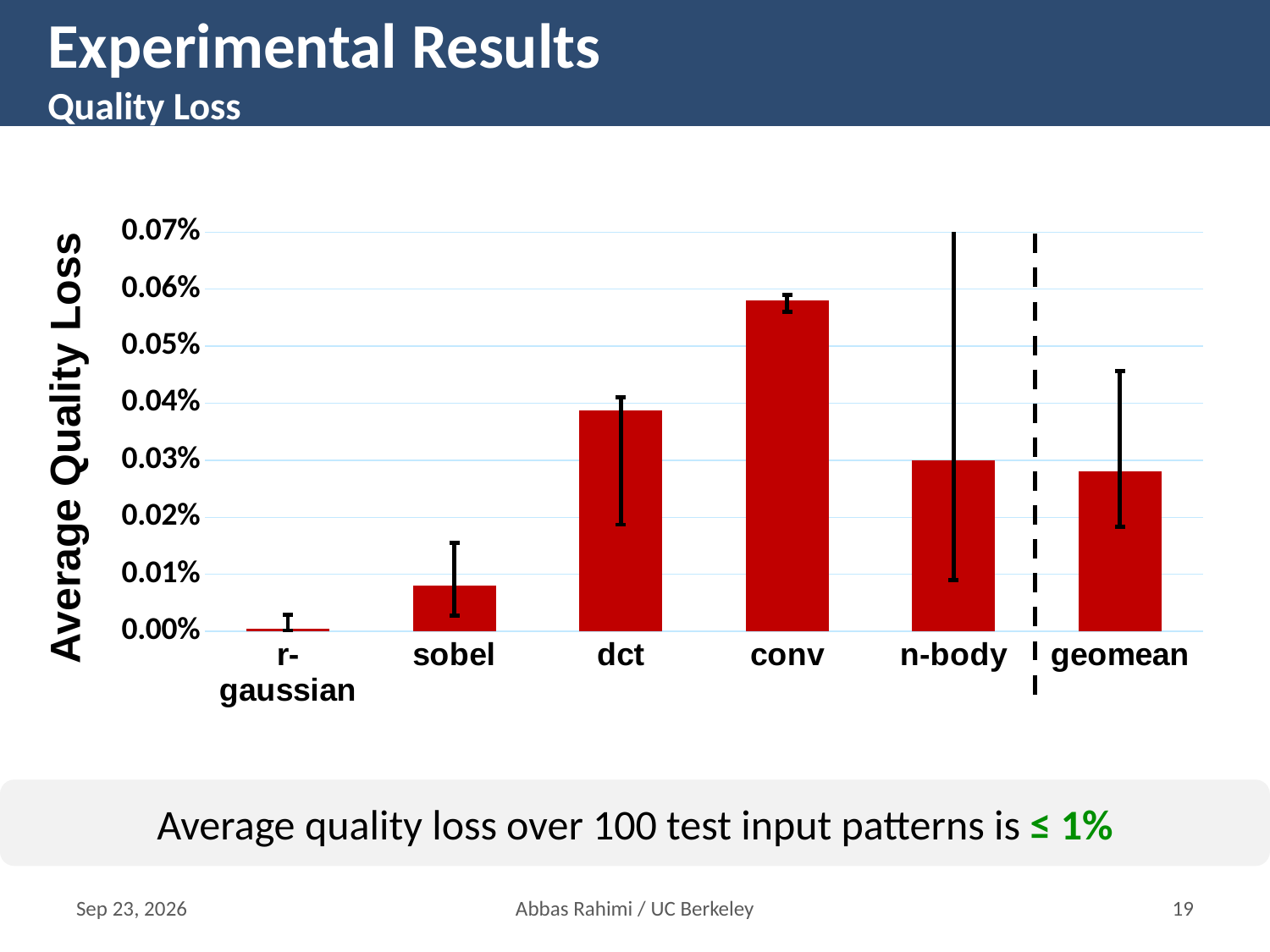
How many categories are plotted on the x axis of the chart? 6 What kind of chart is shown on the slide? bar chart Which category has the highest average quality loss? conv Is the value for dct greater or less than 0.03%? greater What is the label of the y axis of the chart? Average Quality Loss Is the value for conv greater or less than 0.05%? greater Which has a larger average quality loss, conv or n-body? conv Is the value for geomean greater or less than 0.02%? greater Which has a larger average quality loss, dct or sobel? dct Which category has the lowest average quality loss? r-gaussian What colour are the bars in the chart? red